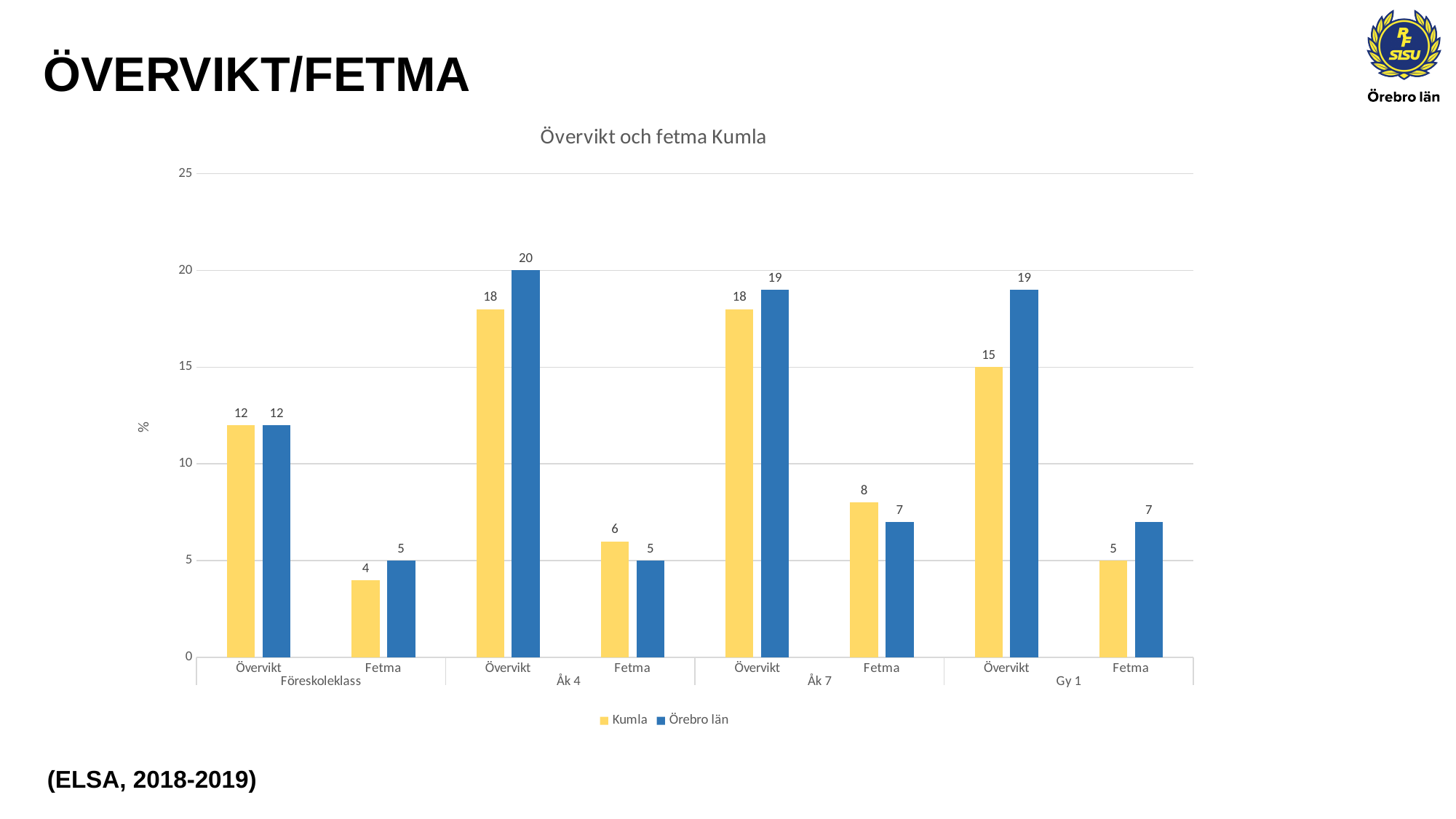
What is the value for Kumla for Övervikt in Åk 4? 18 Which category has the lowest value for Kumla? Fetma, Föreskoleklass Which category has the highest value for Örebro län? Övervikt, Åk 4 What is the value for Örebro län for Fetma in Gy 1? 7 Which is larger for Fetma in Åk 7: Kumla or Örebro län? Kumla What is the value for Kumla for Fetma in Föreskoleklass? 4 How many series does the legend list? 2 What kind of chart is shown? Bar chart What colour are the bars for Kumla? Yellow What is the title of the chart? Övervikt och fetma Kumla Is the value for Kumla for Övervikt in Åk 7 greater or less than 15? greater What is the difference between Örebro län and Kumla for Övervikt in Gy 1? 4